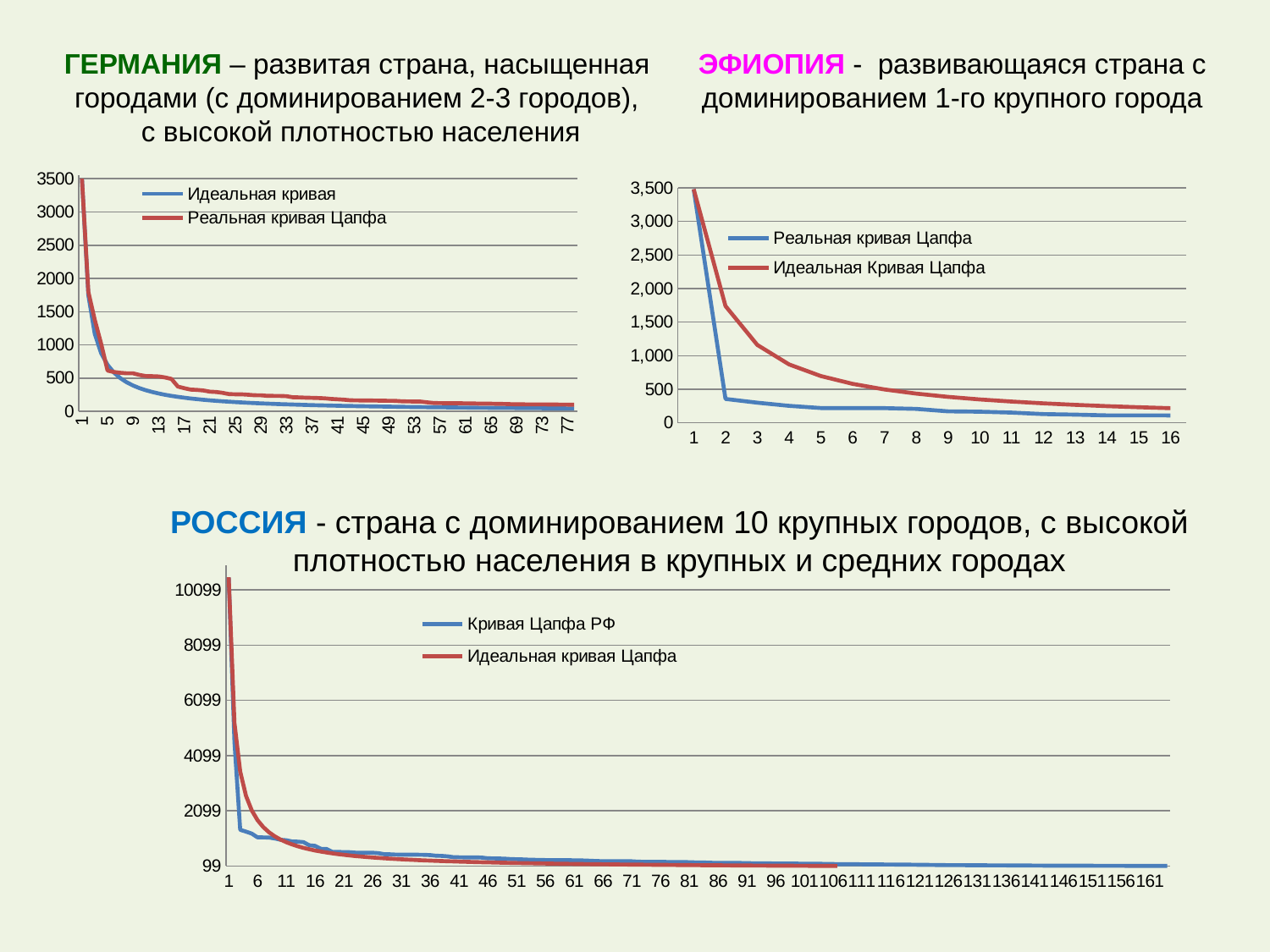
How many points are plotted along the x axis of the ЭФИОПИЯ chart (top right)? 16 In the ЭФИОПИЯ chart (top right), is the value of Реальная кривая Цапфа at point 2 greater or less than 500? less How many series does the legend of the ГЕРМАНИЯ chart (top left) list? 2 In the ЭФИОПИЯ chart (top right), is the value of Идеальная Кривая Цапфа at point 2 greater or less than 1,500? greater In the ЭФИОПИЯ chart (top right), which series has the larger value at point 4, Реальная кривая Цапфа or Идеальная Кривая Цапфа? Идеальная Кривая Цапфа In the РОССИЯ chart (bottom), do the values of Идеальная кривая Цапфа rise or fall along the x axis? fall What kind of chart is the ГЕРМАНИЯ chart (top left)? line chart In the ГЕРМАНИЯ chart (top left), is the value of Реальная кривая Цапфа at point 77 greater or less than 500? less In the РОССИЯ chart (bottom), what colour is the line for Кривая Цапфа РФ? blue In the ГЕРМАНИЯ chart (top left), do the values rise or fall along the x axis? fall What are the two legend entries of the РОССИЯ chart (bottom)? Кривая Цапфа РФ and Идеальная кривая Цапфа